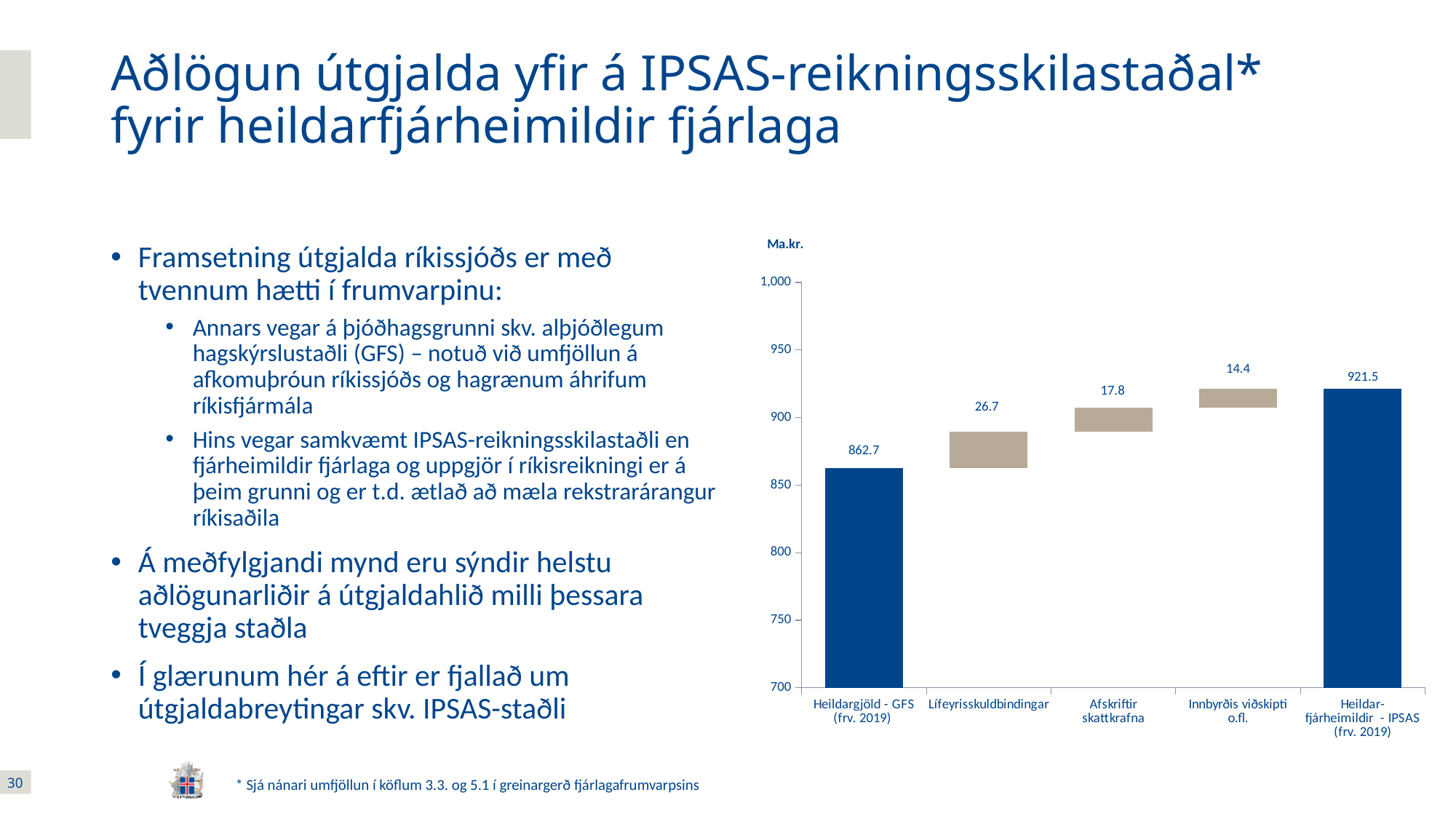
Which category has the highest value? Heildarfjárheimildir - IPSAS (frv. 2019) What is the value for Heildargjöld - GFS (frv. 2019)? 862.7 What is the value for Lífeyrisskuldbindingar? 26.7 What kind of chart is shown on the slide? Bar chart Which is larger, Lífeyrisskuldbindingar or Afskriftir skattkrafna? Lífeyrisskuldbindingar What is the value for Innbyrðis viðskipti o.fl.? 14.4 What is the value for Heildarfjárheimildir - IPSAS (frv. 2019)? 921.5 What is the difference between Heildarfjárheimildir - IPSAS (frv. 2019) and Heildargjöld - GFS (frv. 2019)? 58.8 Which category has the lowest value? Innbyrðis viðskipti o.fl. What is the value for Afskriftir skattkrafna? 17.8 How many categories are shown on the x axis? 5 What unit label is shown above the y axis of the chart? Ma.kr.